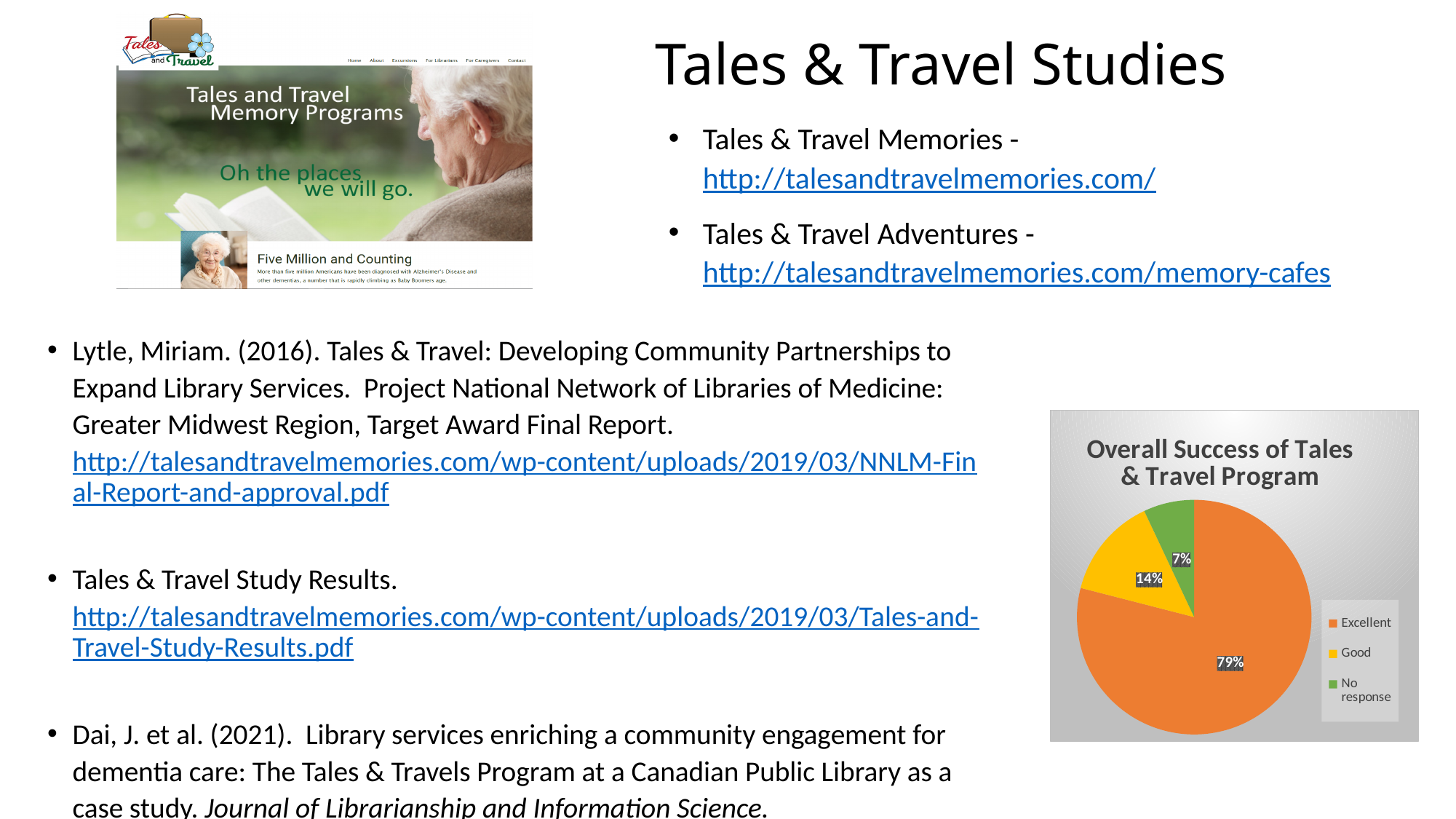
How many categories does the pie chart show? 3 What kind of chart is shown on the slide? pie chart What share of the pie is labelled No response? 7% What is the difference in percentage points between the Excellent and Good slices? 65 Which slice is larger, Good or No response? Good What share of the pie is labelled Excellent? 79% Which category has the smallest slice of the pie? No response Which category has the largest slice of the pie? Excellent What is the title of the chart on the slide? Overall Success of Tales & Travel Program What is the difference in percentage points between the Good and No response slices? 7 What colour is the Excellent slice in the pie chart? orange What share of the pie is labelled Good? 14%